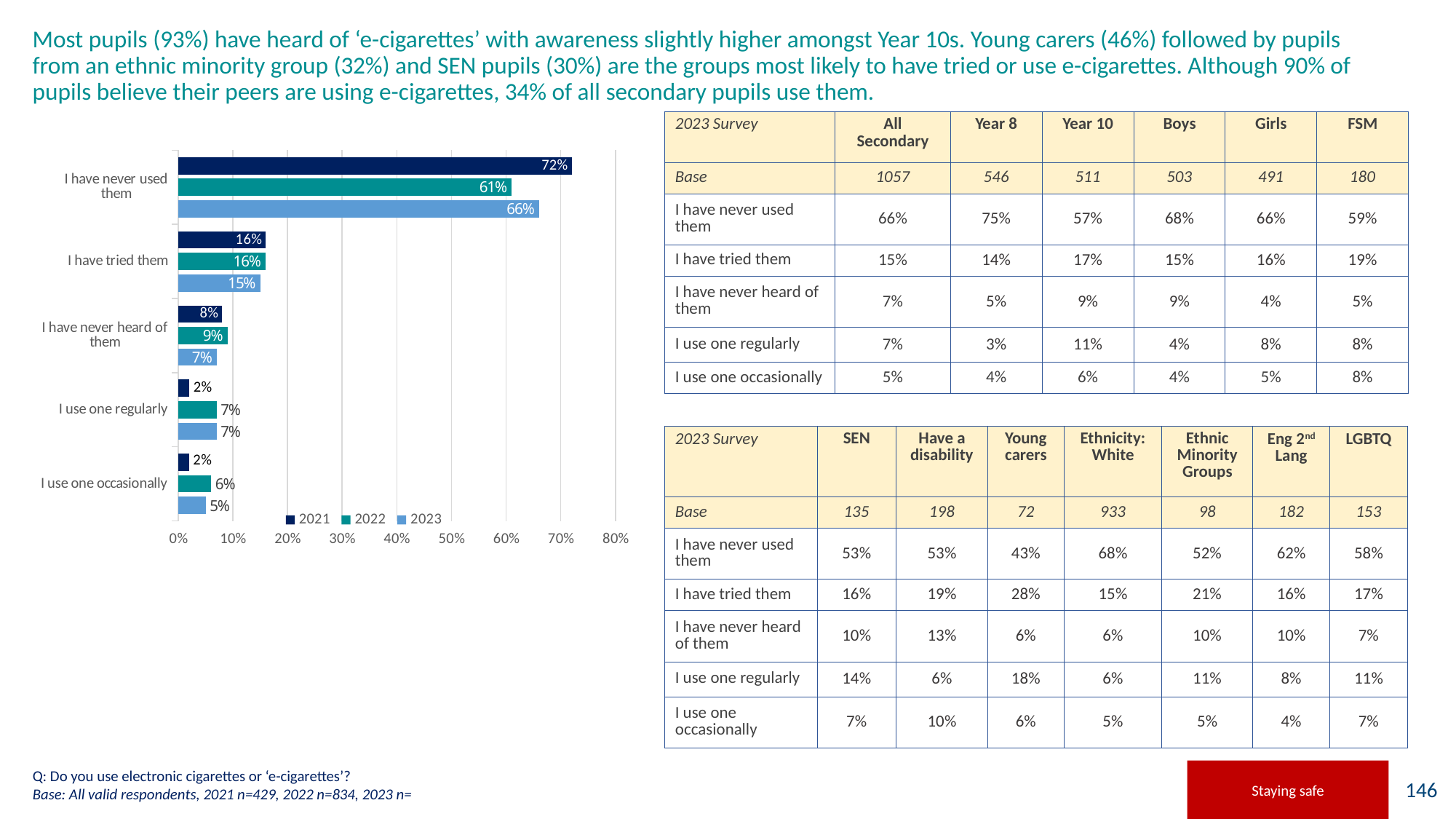
What is the difference between the 2021 and 2022 values for 'I have never used them'? 11% What is the 2023 value for 'I have tried them'? 15% What kind of chart is shown on the slide? bar chart How many categories are shown on the chart? 5 Which category has the lowest 2022 value? I use one occasionally What is the 2022 value for 'I use one occasionally'? 6% How many series does the chart legend list? 3 Which category has the highest 2023 value? I have never used them What is the 2021 value for 'I have never used them'? 72% Which series is shown in the lightest blue colour in the chart? 2023 Is the 2022 value for 'I have never used them' greater or less than 50%? greater Which is larger: the 2021 value for 'I use one regularly' or the 2023 value for 'I use one regularly'? 2023